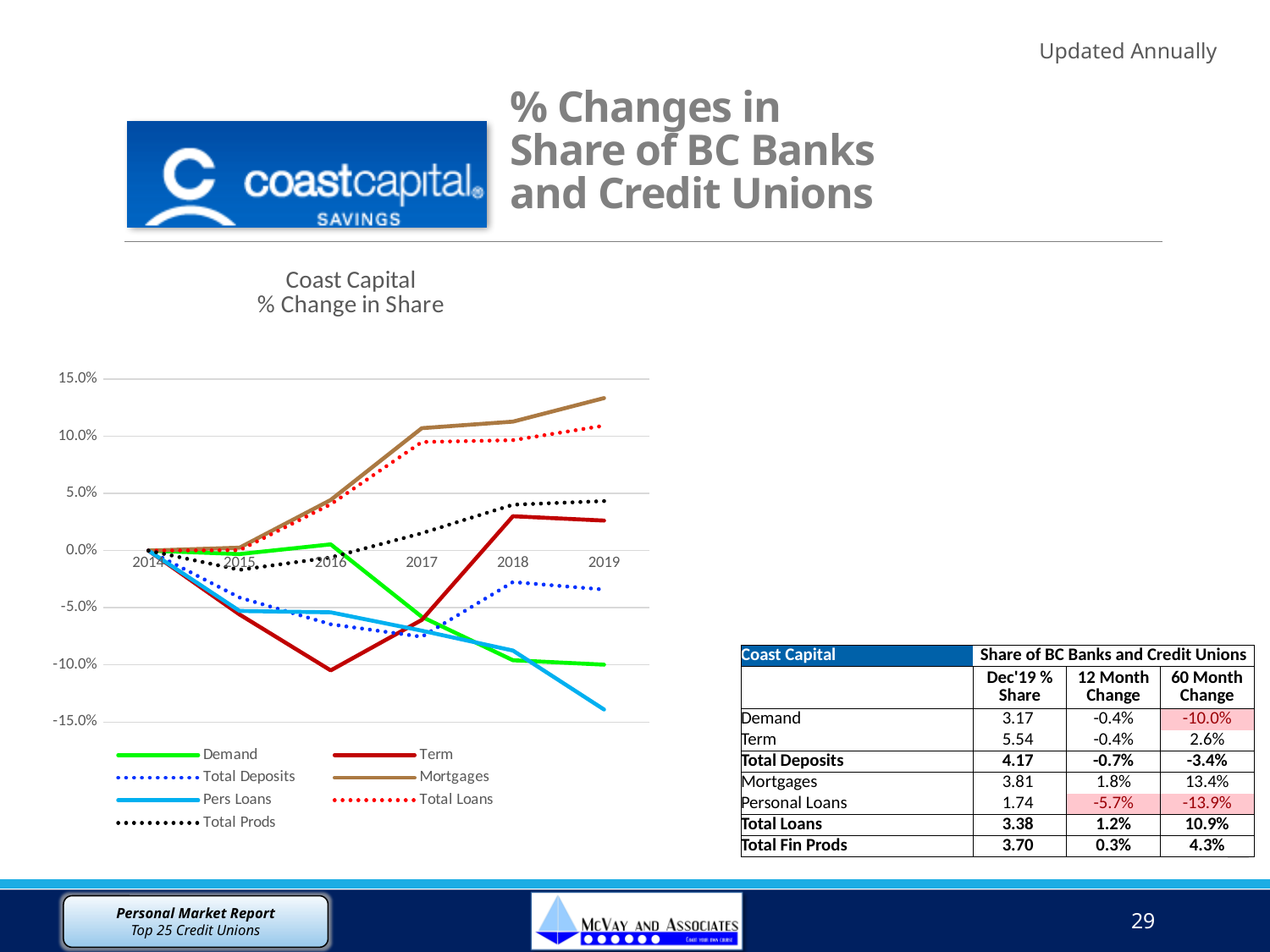
Is the value for Demand in 2018 greater or less than -5.0%? less How many years are shown along the x axis of the chart? 6 Does the Mortgages series rise or fall from 2014 to 2019? rise Which series has the highest value in 2019? Mortgages Is the value for Mortgages in 2019 greater or less than 10.0%? greater How many series does the chart legend list? 7 Is the value for Pers Loans in 2019 greater or less than -10.0%? less What is the title of the chart? Coast Capital % Change in Share What kind of chart is shown on the slide? line chart Which series has the lowest value in 2019? Pers Loans In 2019, which is larger: the value for Mortgages or the value for Demand? Mortgages